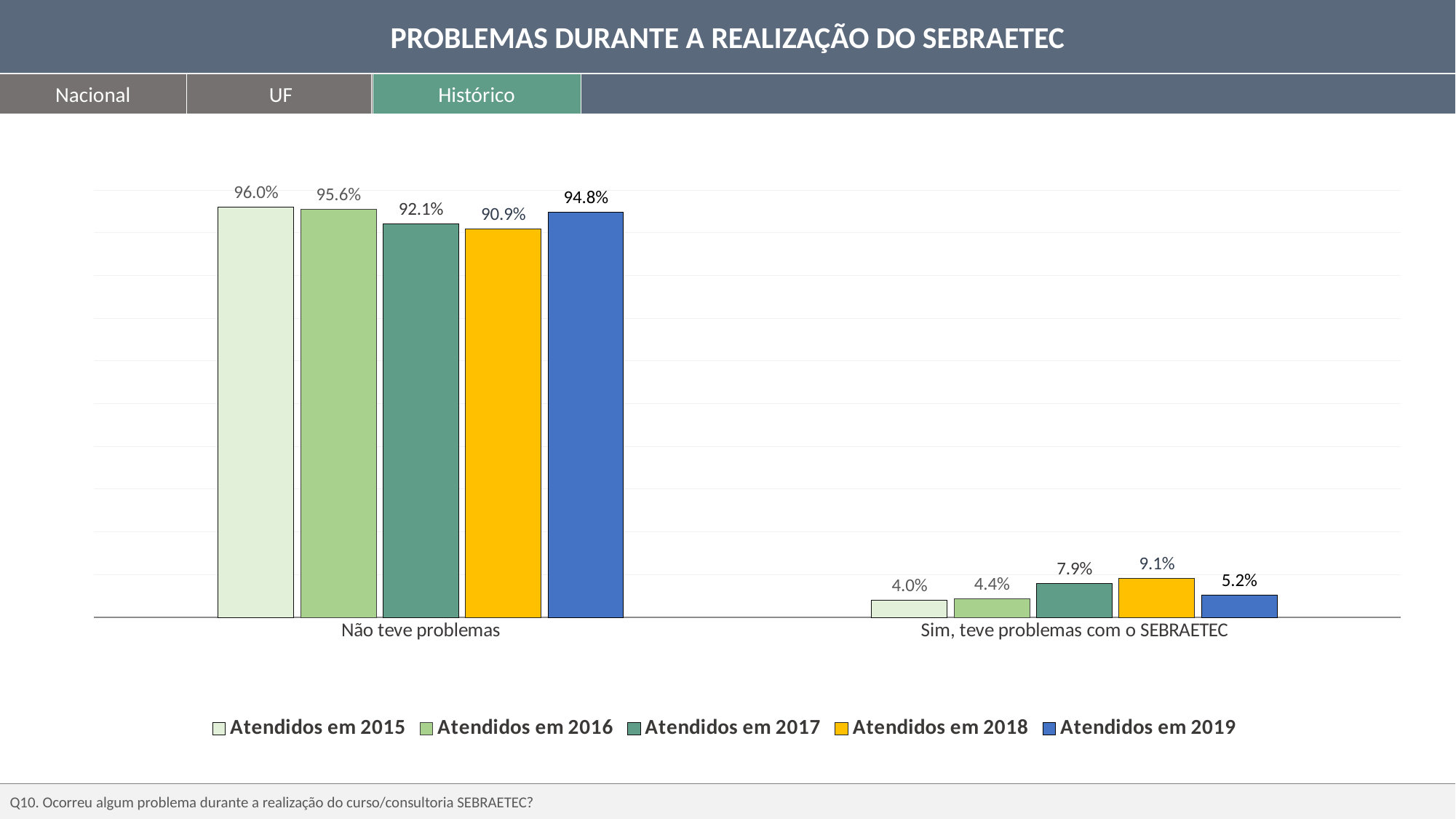
What is the difference between the 'Atendidos em 2015' and 'Atendidos em 2018' values in the 'Não teve problemas' category? 5.1% What is the value for 'Atendidos em 2018' in the 'Sim, teve problemas com o SEBRAETEC' category? 9.1% In the 'Sim, teve problemas com o SEBRAETEC' category, which is larger: 'Atendidos em 2017' or 'Atendidos em 2019'? Atendidos em 2017 What is the value for 'Atendidos em 2019' in the 'Não teve problemas' category? 94.8% What kind of chart is shown on the slide? Bar chart What is the value for 'Atendidos em 2015' in the 'Não teve problemas' category? 96.0% How many series does the legend list? 5 Which series has the lowest value in the 'Não teve problemas' category? Atendidos em 2018 How many categories are shown on the x axis? 2 What is the title of the slide? PROBLEMAS DURANTE A REALIZAÇÃO DO SEBRAETEC Which series has the highest value in the 'Sim, teve problemas com o SEBRAETEC' category? Atendidos em 2018 Which tab is highlighted in green below the title? Histórico